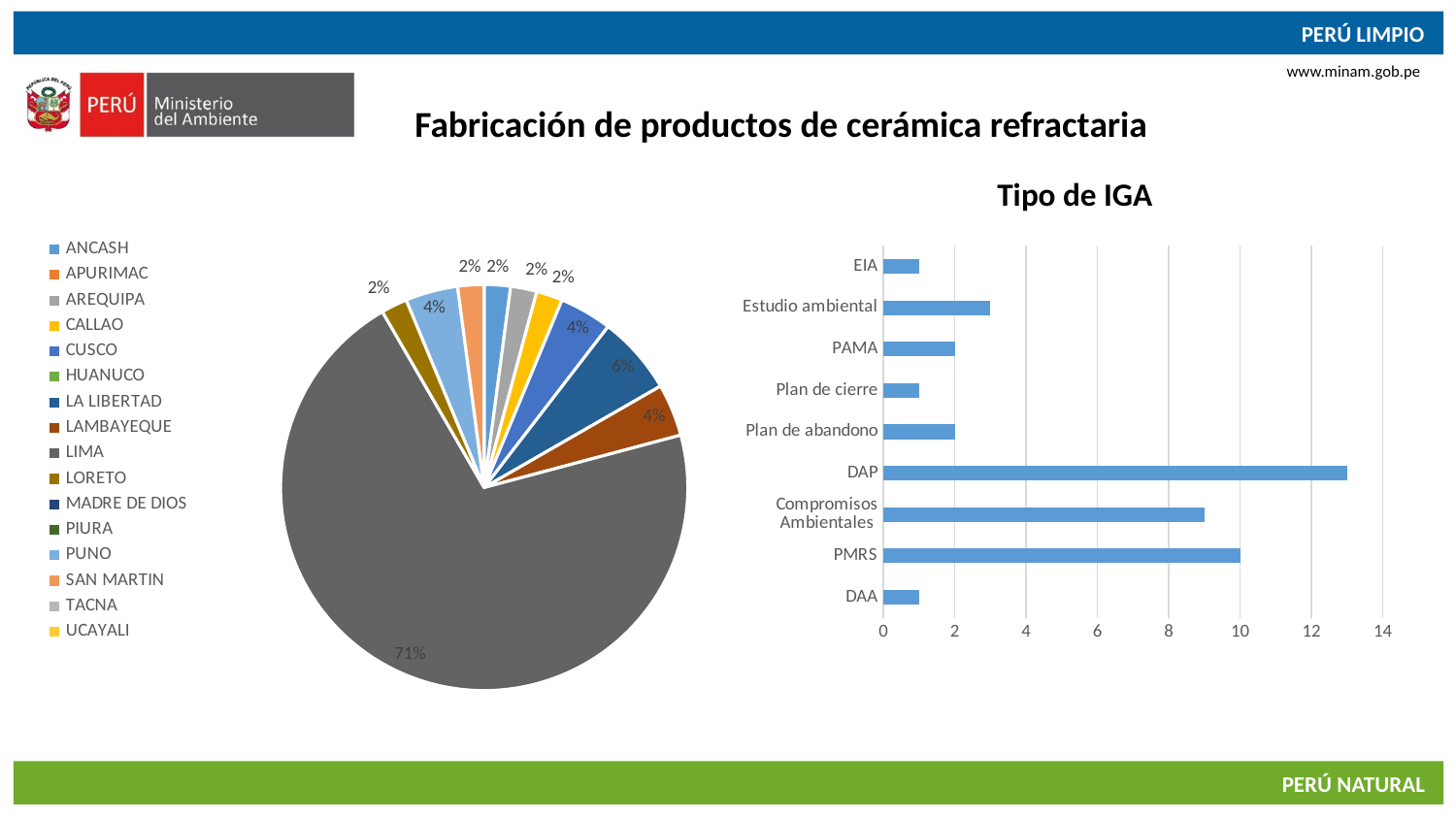
What is the title of the bar chart on the right of the slide? Tipo de IGA In the pie chart on the left, what share does LIMA have? 71% In the 'Tipo de IGA' chart, is the value for PAMA greater or less than 4? less In the 'Tipo de IGA' chart, is the value for DAP greater or less than 12? greater How many categories are shown in the 'Tipo de IGA' chart? 9 What type of chart is the chart on the left of the slide? pie chart In the 'Tipo de IGA' chart, is the value for Estudio ambiental greater or less than 2? greater In the pie chart on the left, which region has the largest share? LIMA In the 'Tipo de IGA' chart, which category has the highest value? DAP What type of chart is the 'Tipo de IGA' chart? bar chart In the 'Tipo de IGA' chart, which is larger, the value for DAP or the value for PMRS? DAP How many regions are listed in the legend of the pie chart on the left? 16